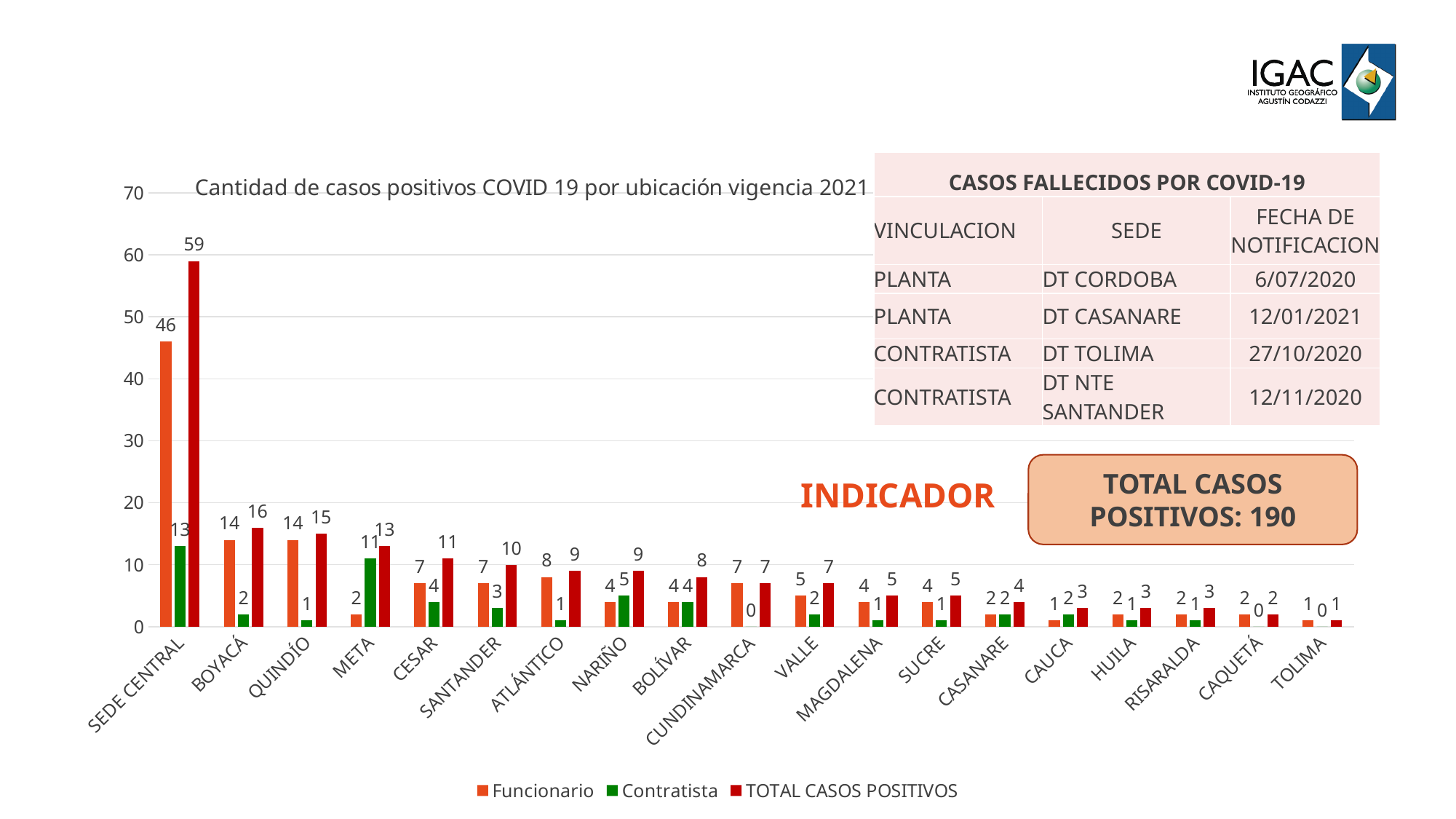
What is the TOTAL CASOS POSITIVOS value for BOYACÁ? 16 How many series does the legend list? 3 Which is larger for META: the Funcionario value or the Contratista value? Contratista What is the difference between the TOTAL CASOS POSITIVOS for SEDE CENTRAL and BOYACÁ? 43 What is the Funcionario value for SEDE CENTRAL? 46 What kind of chart is shown? Bar chart How many locations are shown on the x axis? 19 Which location has the lowest TOTAL CASOS POSITIVOS? TOLIMA Do the TOTAL CASOS POSITIVOS values generally rise or fall from left to right along the x axis? Fall Which location has the highest TOTAL CASOS POSITIVOS? SEDE CENTRAL What is the title of the chart? Cantidad de casos positivos COVID 19 por ubicación vigencia 2021 What is the Contratista value for META? 11